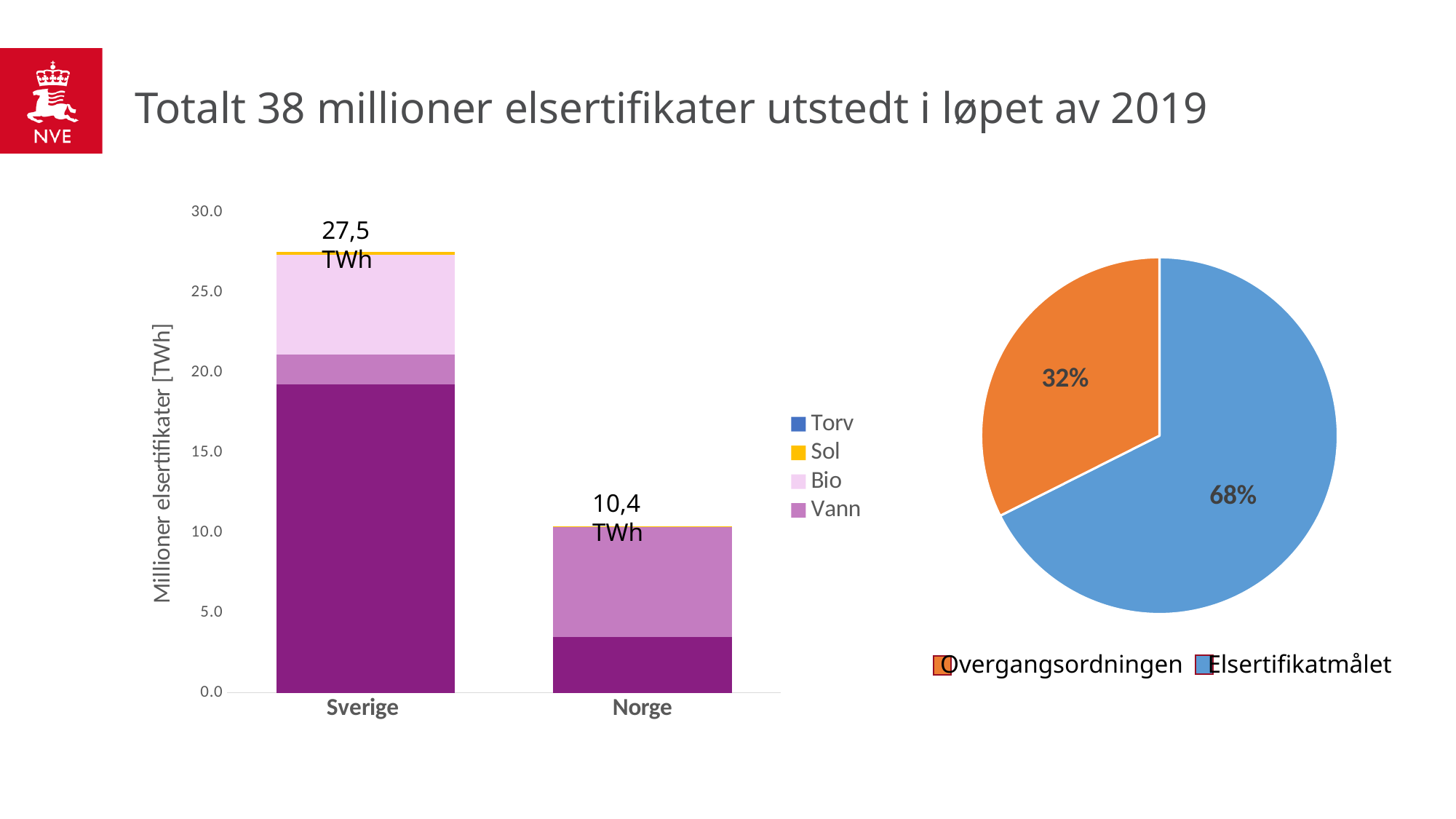
In the bar chart on the left, what is the difference between the totals for Sverige and Norge? 17,1 TWh In the bar chart on the left, is the total for Norge greater or less than 15.0? less What kind of chart is shown on the right of the slide? Pie chart In the bar chart on the left, what is the total value labelled for Sverige? 27,5 TWh In the bar chart on the left, which country has the higher total? Sverige What kind of chart is shown on the left of the slide? Stacked bar chart In the bar chart on the left, how many series does the legend list? 4 In the bar chart on the left, how many countries are shown on the x axis? 2 In the pie chart on the right, which slice is the largest? Elsertifikatmålet In the pie chart on the right, what share does Overgangsordningen have? 32% In the bar chart on the left, what is the label on the y axis? Millioner elsertifikater [TWh] In the bar chart on the left, what is the total value labelled for Norge? 10,4 TWh